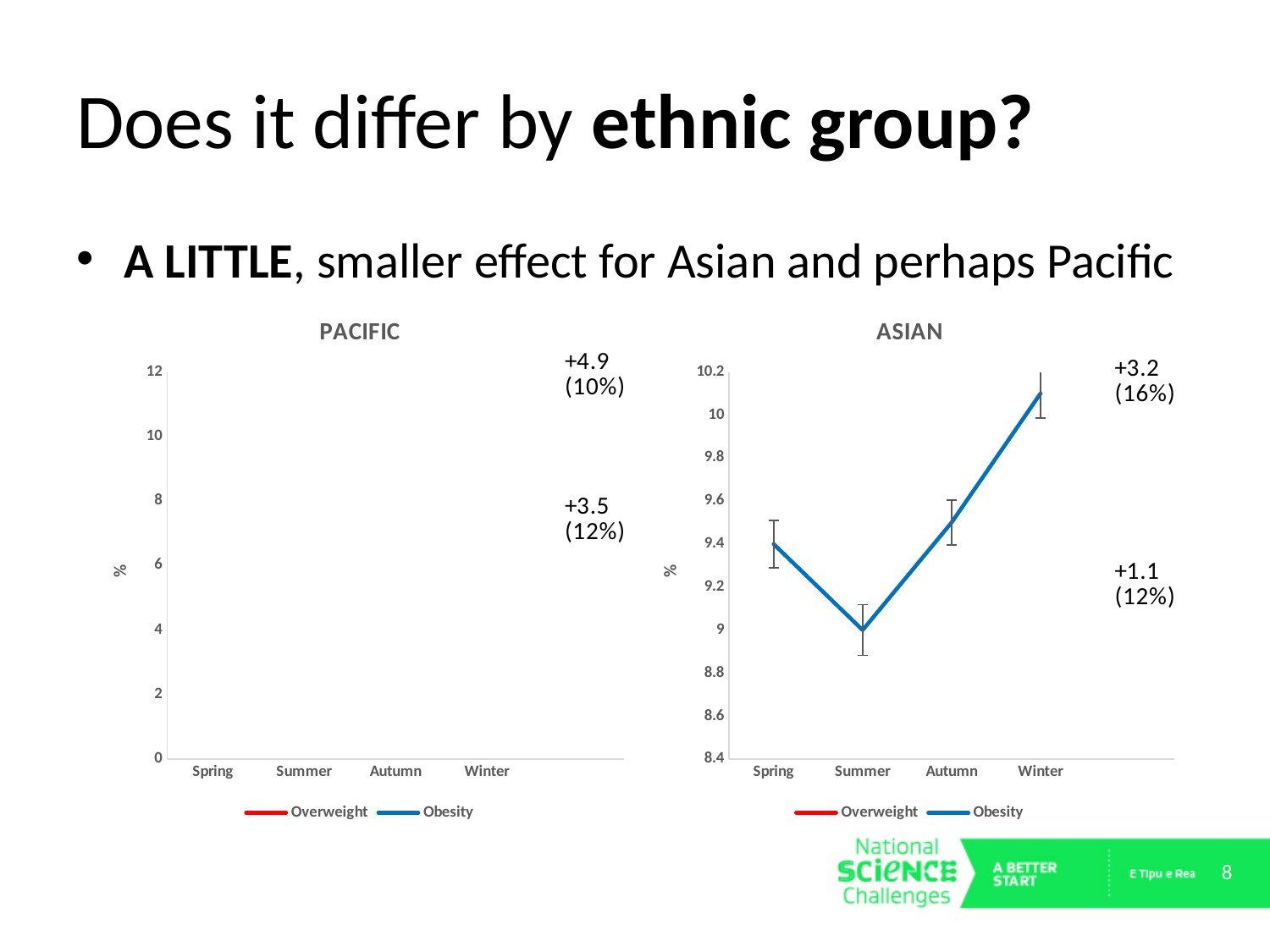
In the ASIAN chart, does the Obesity line rise or fall from Summer to Winter? rise In the PACIFIC chart, how many categories are on the x axis? 4 In the ASIAN chart, which season has the highest Obesity value? Winter In the ASIAN chart, which is larger, the Obesity value for Winter or for Spring? Winter In the ASIAN chart, how many series does the legend list? 2 In the ASIAN chart, how many categories are on the x axis? 4 In the ASIAN chart, which season has the lowest Obesity value? Summer In the ASIAN chart, is the Obesity value for Spring greater or less than 9.2? greater In the ASIAN chart, is the Obesity value for Summer greater or less than 9.2? less In the ASIAN chart, is the Obesity value for Winter greater or less than 10? greater In the PACIFIC chart, what is the label on the y axis? % In the ASIAN chart, what kind of chart is shown? line chart